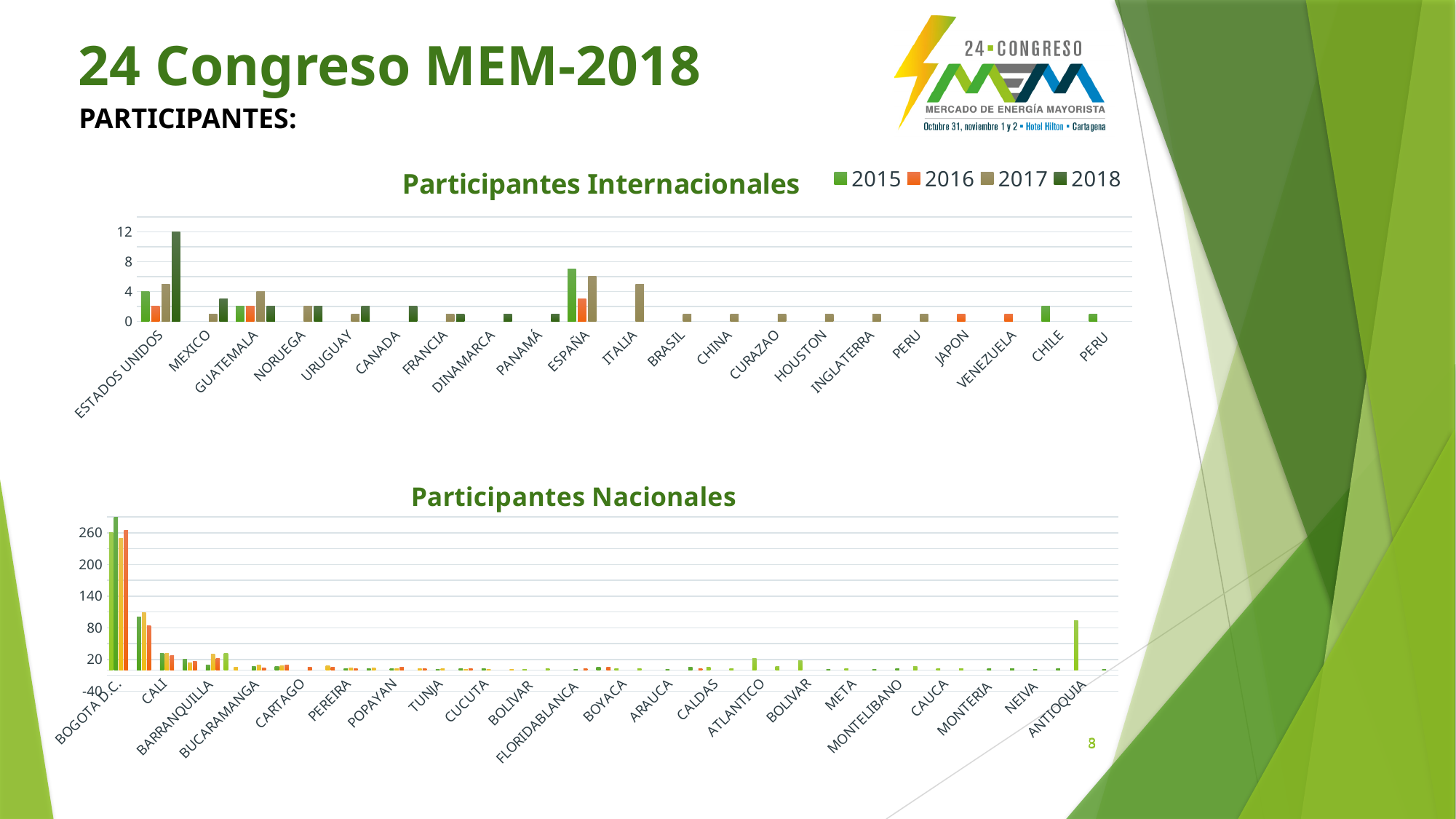
In the "Participantes Internacionales" chart, what is the value for ESTADOS UNIDOS in 2015? 4 In the "Participantes Internacionales" chart, what is the value for ESTADOS UNIDOS in 2018? 12 How many series does the legend list for the "Participantes Internacionales" chart? 4 How many countries are labelled on the x axis of the "Participantes Internacionales" chart? 21 In the "Participantes Internacionales" chart, is the 2015 value for ESPAÑA greater or less than 4? greater In the "Participantes Nacionales" chart, is the 2015 value for ANTIOQUIA greater or less than 80? greater Which series is shown in orange in the legend? 2016 In the "Participantes Internacionales" chart, which country has the tallest bar overall? ESTADOS UNIDOS What kind of chart is the "Participantes Internacionales" chart? bar chart In the "Participantes Nacionales" chart, which city has the tallest bars? BOGOTA D.C. In the "Participantes Internacionales" chart, which is larger: the 2018 value for ESTADOS UNIDOS or the 2015 value for ESPAÑA? 2018 value for ESTADOS UNIDOS In the "Participantes Internacionales" chart, is the 2017 value for ITALIA greater or less than 8? less